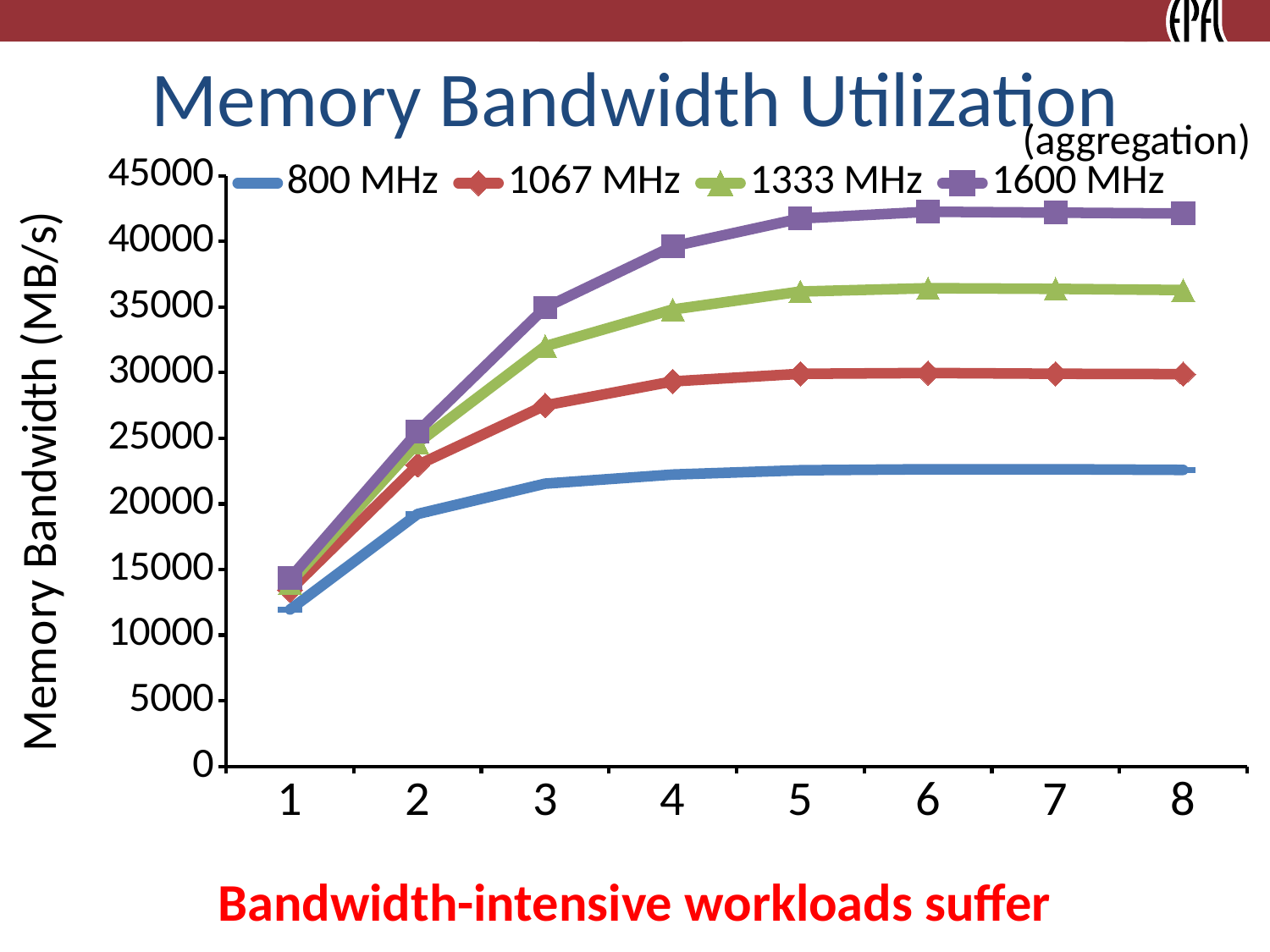
Is the value for 1067 MHz at x = 1 greater or less than 15000? less How many points are plotted along the x axis for each series? 8 Is the value for 800 MHz at x = 2 greater or less than 20000? less Is the value for 800 MHz at x = 8 greater or less than 25000? less How many series does the legend list? 4 At x = 8, which is larger: the value for 1333 MHz or the value for 1067 MHz? 1333 MHz Do the values for 1600 MHz rise or fall from x = 1 to x = 5? rise What is the label of the y axis? Memory Bandwidth (MB/s) What kind of chart is shown on the slide? line chart Which series has the lowest memory bandwidth at x = 8? 800 MHz Which series has the highest memory bandwidth at x = 8? 1600 MHz